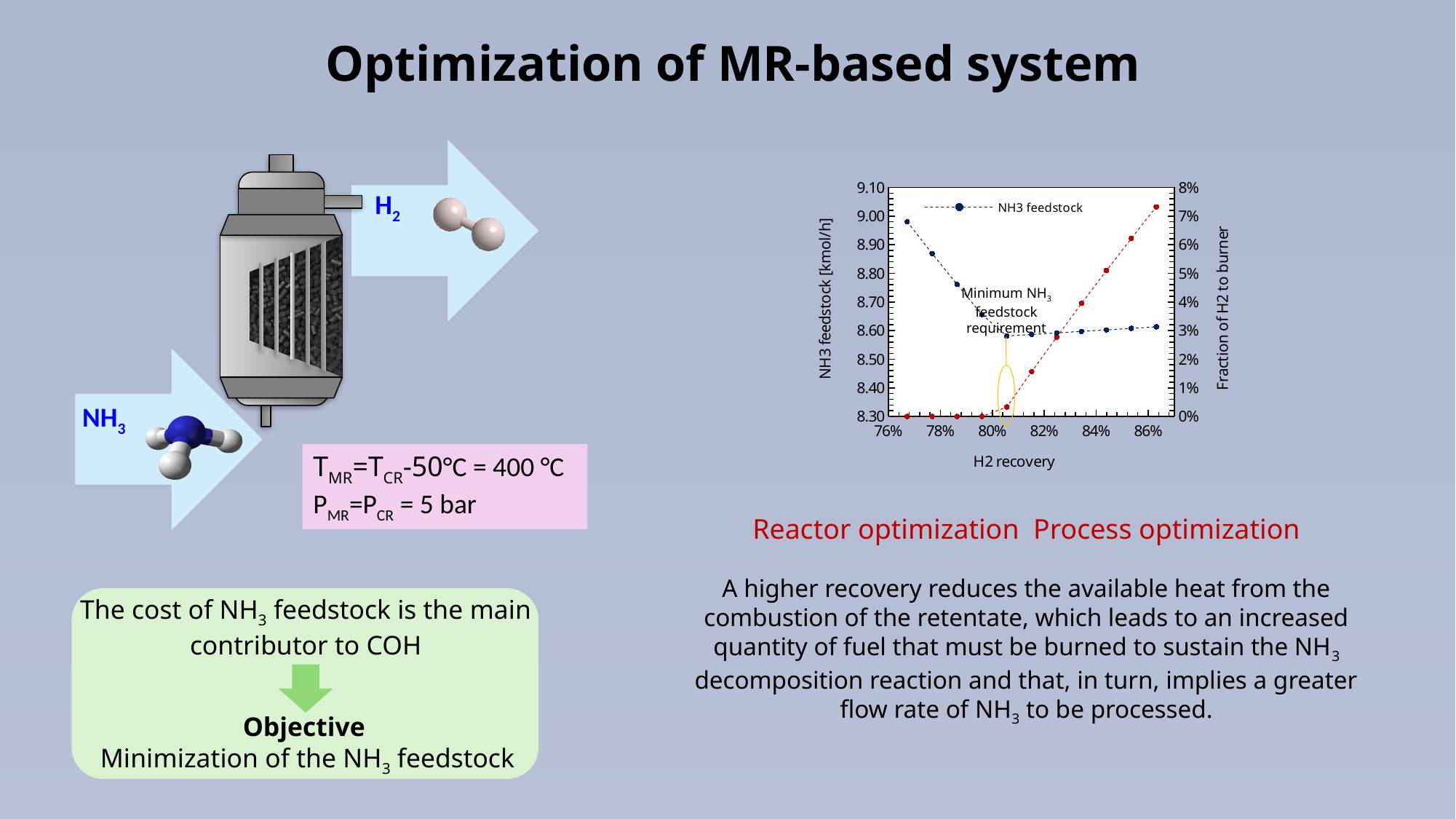
What kind of chart is shown on the slide? line chart Which is larger: the NH3 feedstock at about 77% H2 recovery or at about 86% H2 recovery? 77% H2 recovery Does the NH3 feedstock rise or fall as H2 recovery increases from 76% to 80%? fall How many series names does the chart's legend list? 1 Is the fraction of H2 to burner at about 78% H2 recovery greater or less than 1%? less Which is larger: the fraction of H2 to burner at about 80% H2 recovery or at about 86% H2 recovery? 86% H2 recovery Is the NH3 feedstock at about 86% H2 recovery greater or less than 8.70 kmol/h? less Does the fraction of H2 to burner rise or fall as H2 recovery increases from 80% to 86%? rise What series name does the chart's legend list? NH3 feedstock Is the fraction of H2 to burner at about 85% H2 recovery greater or less than 5%? greater What is the title of the right-hand vertical axis of the chart? Fraction of H2 to burner